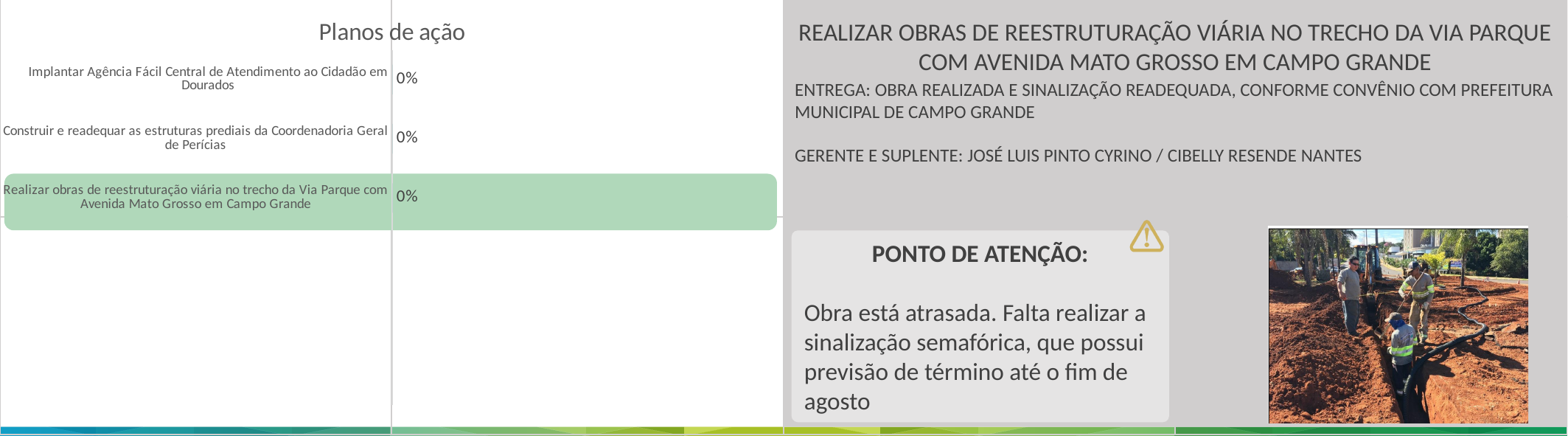
In the 'Planos de ação' chart, which category is highlighted with a green background? Realizar obras de reestruturação viária no trecho da Via Parque com Avenida Mato Grosso em Campo Grande In the 'Planos de ação' chart, what value is shown for 'Implantar Agência Fácil Central de Atendimento ao Cidadão em Dourados'? 0% What is the title of the chart on the left side of the slide? Planos de ação How many categories are listed in the 'Planos de ação' chart? 3 In the 'Planos de ação' chart, do any of the categories show a value greater than 0%? No In the 'Planos de ação' chart, what is the difference between the value for 'Implantar Agência Fácil Central de Atendimento ao Cidadão em Dourados' and the value for 'Construir e readequar as estruturas prediais da Coordenadoria Geral de Perícias'? 0% In the 'Planos de ação' chart, what value is shown for 'Construir e readequar as estruturas prediais da Coordenadoria Geral de Perícias'? 0% What kind of chart is the 'Planos de ação' chart? Bar chart In the 'Planos de ação' chart, what value is shown for 'Realizar obras de reestruturação viária no trecho da Via Parque com Avenida Mato Grosso em Campo Grande'? 0%